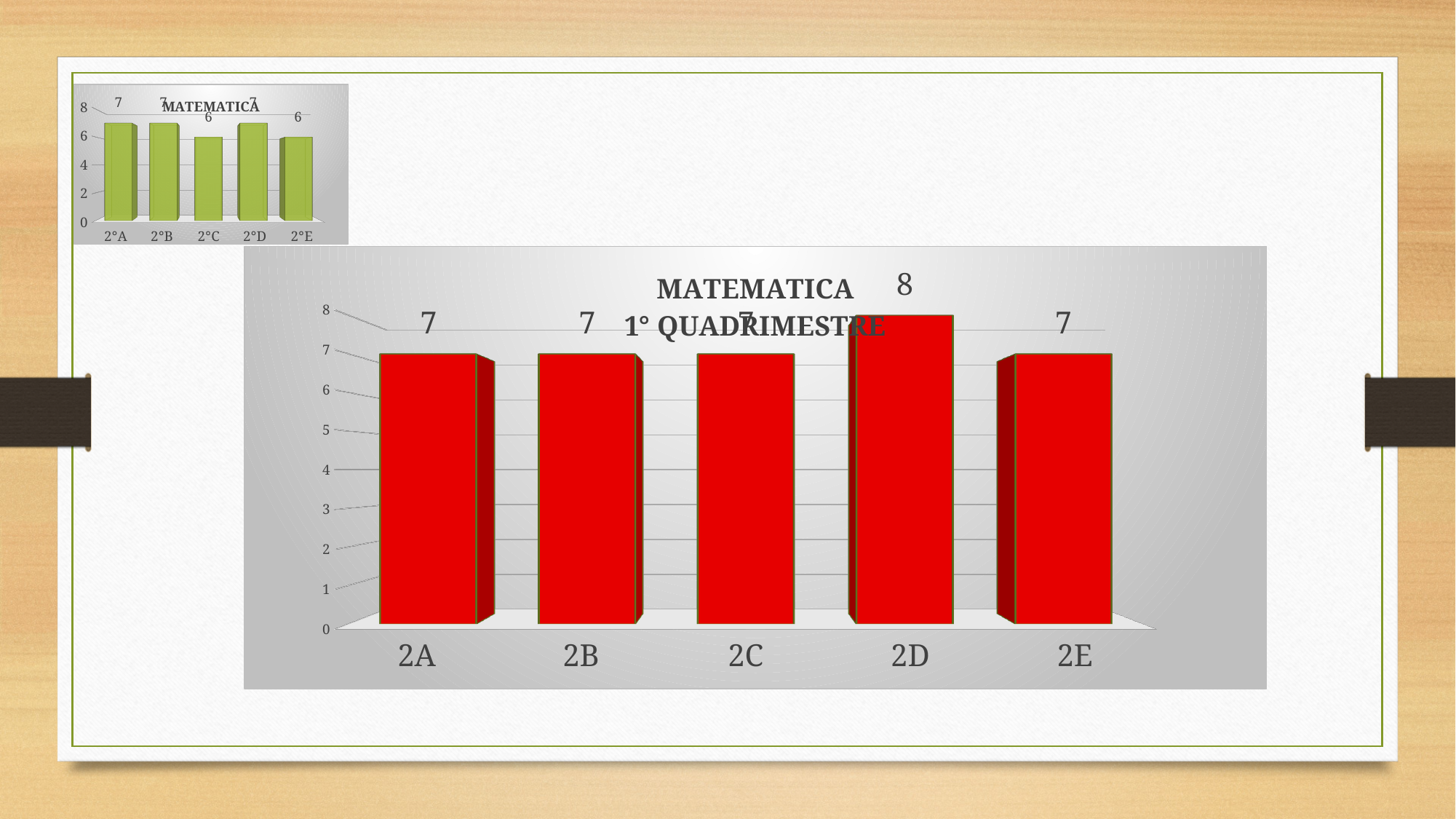
What colour are the bars in the large chart titled MATEMATICA 1° QUADRIMESTRE? Red In the small chart at the top left titled MATEMATICA, what is the value for 2°C? 6 In the large chart titled MATEMATICA 1° QUADRIMESTRE, what is the value for 2A? 7 In the large chart titled MATEMATICA 1° QUADRIMESTRE, what kind of chart is it? Bar chart In the small chart at the top left titled MATEMATICA, what is the difference between the values for 2°A and 2°C? 1 In the small chart at the top left titled MATEMATICA, what is the value for 2°D? 7 In the large chart titled MATEMATICA 1° QUADRIMESTRE, how many categories are shown on the x axis? 5 In the large chart titled MATEMATICA 1° QUADRIMESTRE, what is the difference between the values for 2D and 2E? 1 In the small chart at the top left titled MATEMATICA, which is larger, the value for 2°B or the value for 2°E? 2°B In the large chart titled MATEMATICA 1° QUADRIMESTRE, is the value for 2D greater or less than 7? greater In the large chart titled MATEMATICA 1° QUADRIMESTRE, what is the value for 2D? 8 In the large chart titled MATEMATICA 1° QUADRIMESTRE, which category has the highest value? 2D